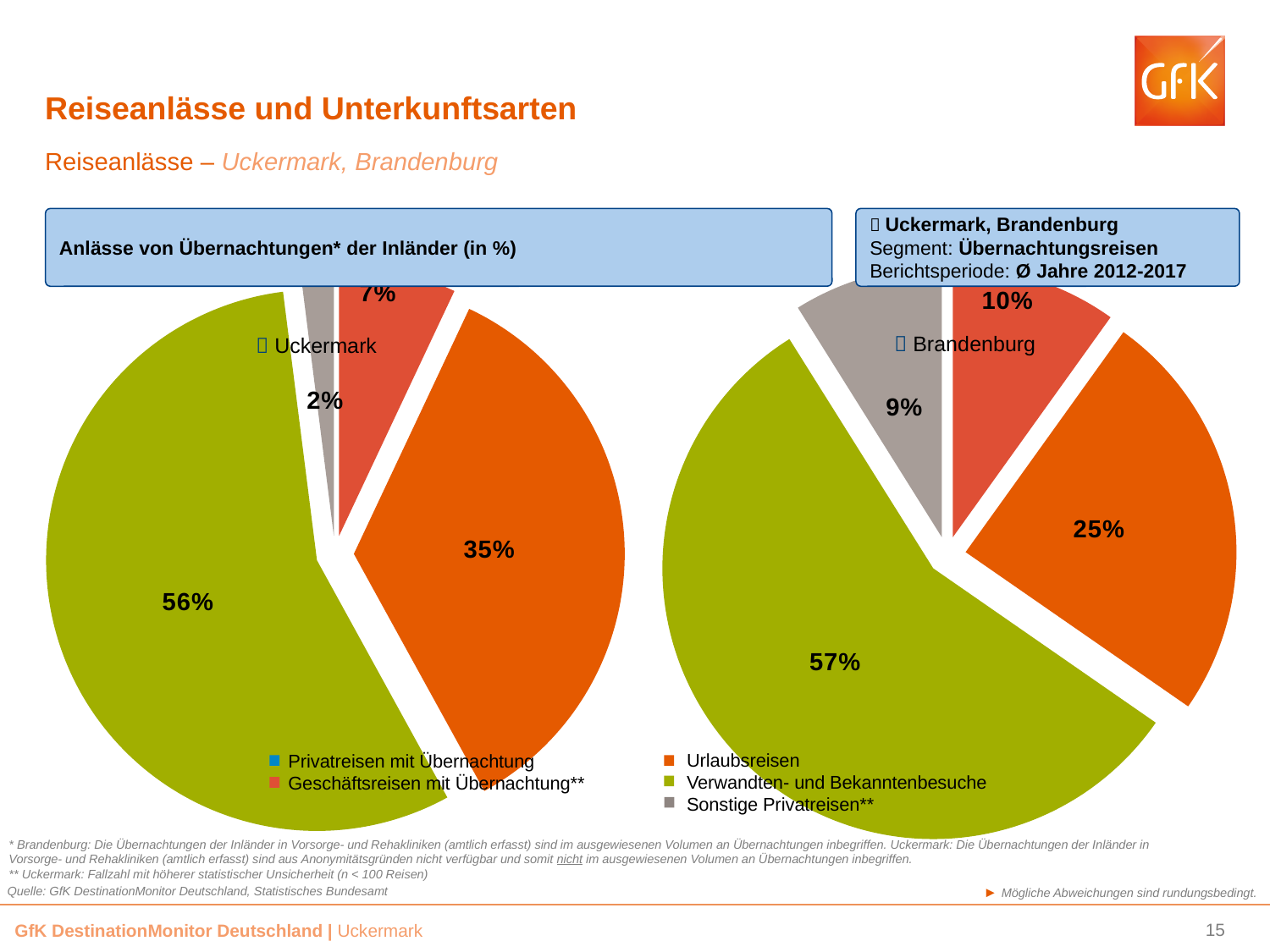
In the Uckermark pie chart, what share is Sonstige Privatreisen? 2% In the Brandenburg pie chart, which category has the largest share? Verwandten- und Bekanntenbesuche In the Brandenburg pie chart, what share is Geschäftsreisen mit Übernachtung? 10% In the Brandenburg pie chart, what share is Urlaubsreisen? 25% Which is larger: the Sonstige Privatreisen share in Uckermark or in Brandenburg? Brandenburg In the Uckermark pie chart, what share is Urlaubsreisen? 35% In the Brandenburg pie chart, what share is Verwandten- und Bekanntenbesuche? 57% What is the difference between the Urlaubsreisen share in Uckermark (35%) and in Brandenburg (25%)? 10 percentage points In the Uckermark pie chart, what share is Verwandten- und Bekanntenbesuche? 56% In the Uckermark pie chart, which category has the smallest share? Sonstige Privatreisen In the Brandenburg pie chart, what share is Sonstige Privatreisen? 9% What kind of charts are shown on the slide? Pie charts